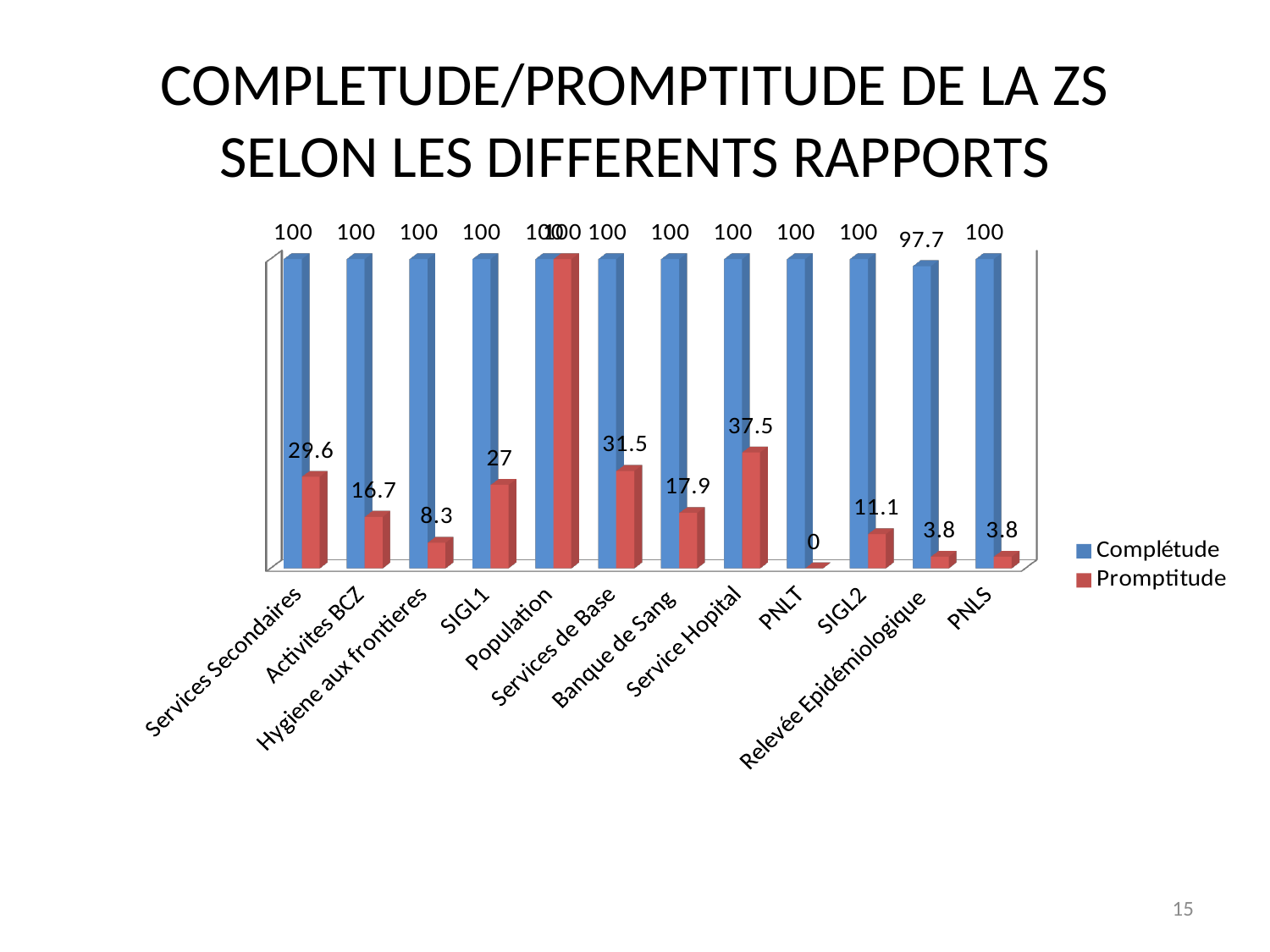
What kind of chart is shown on the slide? Bar chart Which category has the lowest Promptitude value? PNLT What is the Promptitude value for PNLT? 0 What is the Promptitude value for Service Hopital? 37.5 How many series does the legend list? 2 What is the Promptitude value for Hygiene aux frontieres? 8.3 Which category has the lowest Complétude value? Relevée Epidémiologique Which has a larger Promptitude value, Services Secondaires or SIGL1? Services Secondaires How many categories are shown on the x axis? 12 What is the difference between the Promptitude values for Services de Base and Activites BCZ? 14.8 Which category has the highest Promptitude value? Population What is the Complétude value for Relevée Epidémiologique? 97.7